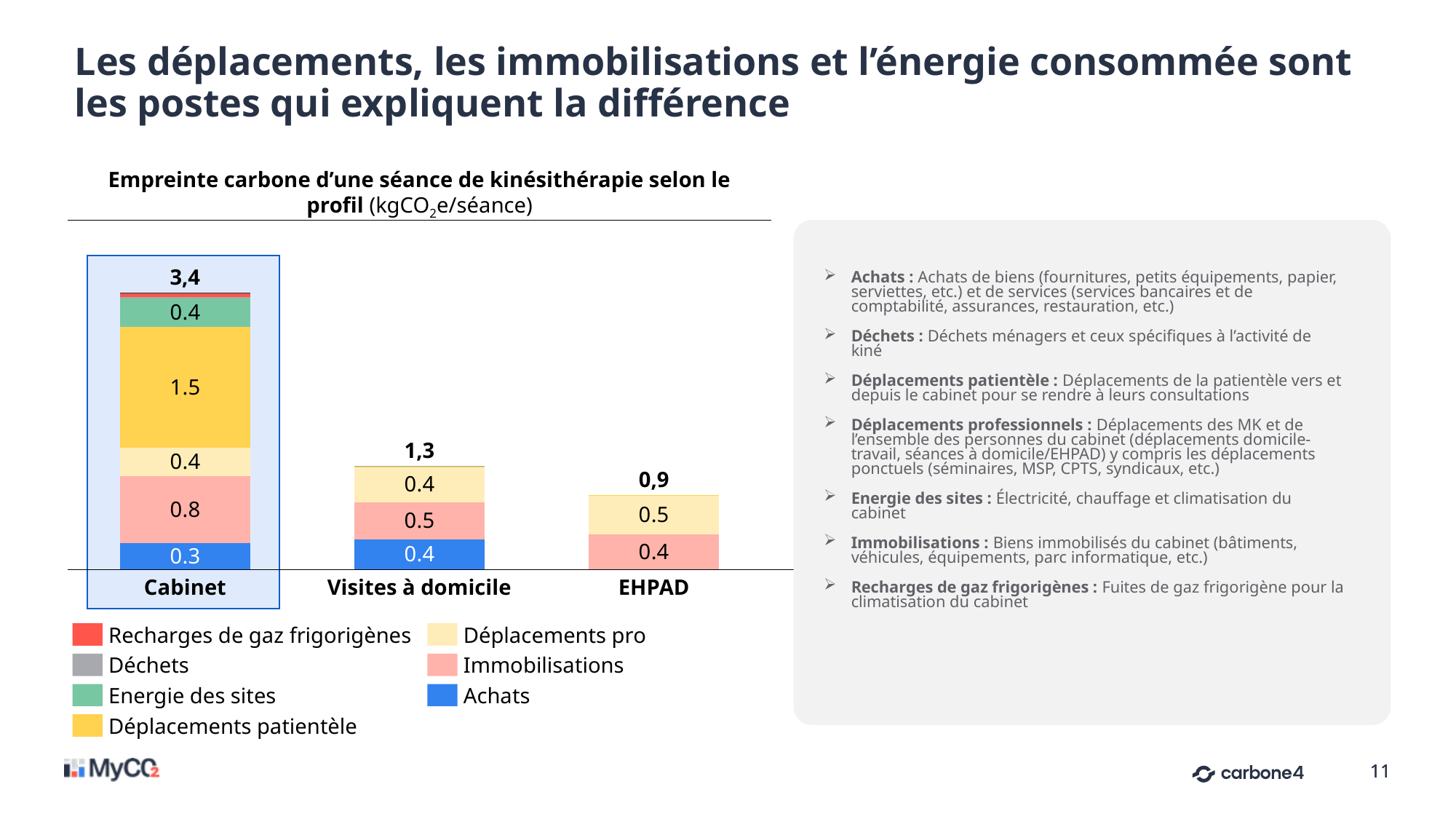
Which profile has the highest total carbon footprint? Cabinet What is the total carbon footprint shown for the EHPAD profile? 0,9 What is the total carbon footprint shown for the Cabinet profile? 3,4 What type of chart is shown on the slide? Stacked bar chart Which profile has the lowest total carbon footprint? EHPAD What is the difference between the total for Cabinet (3,4) and the total for Visites à domicile (1,3)? 2,1 How many series does the chart legend list? 7 Which is larger: the Achats value for Cabinet or the Achats value for Visites à domicile? Visites à domicile What is the value of Déplacements patientèle for the Cabinet profile? 1.5 What is the value of Immobilisations for the Visites à domicile profile? 0.5 How many profiles (categories) are shown on the x axis of the chart? 3 What is the value of Déplacements pro for the EHPAD profile? 0.5